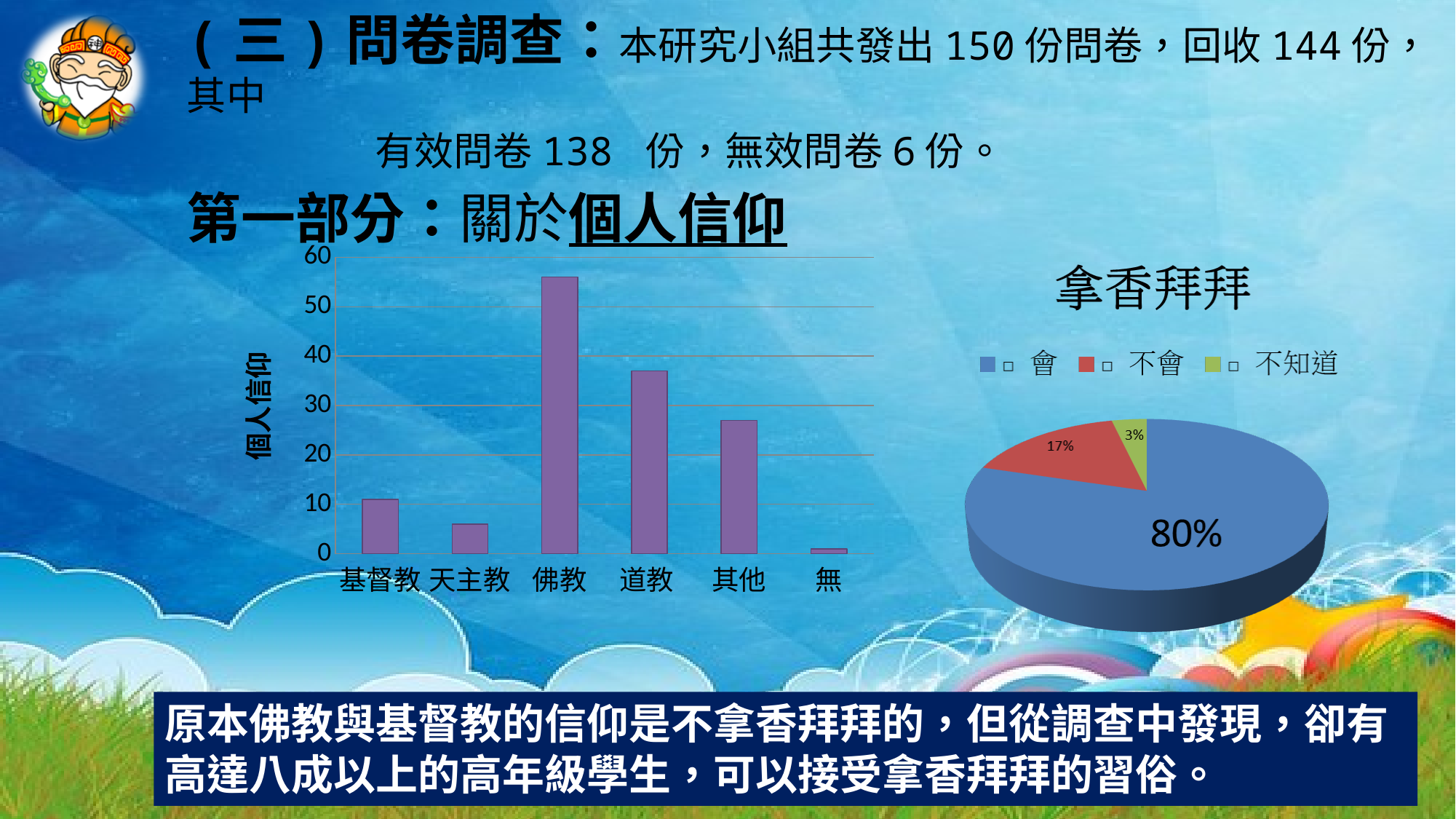
How many entries does the legend of the pie chart 拿香拜拜 list? 3 In the left bar chart (個人信仰), which category has the highest bar? 佛教 How many categories are shown on the x axis of the left bar chart (個人信仰)? 6 What kind of chart is the right chart titled 拿香拜拜? pie chart In the left bar chart (個人信仰), is the value for 天主教 greater or less than 10? less In the left bar chart (個人信仰), which is larger, the value for 道教 or the value for 其他? 道教 What kind of chart is the left chart with the y-axis labelled 個人信仰? bar chart In the pie chart 拿香拜拜, what share does 會 have? 80% In the pie chart 拿香拜拜, what is the difference in percentage points between 會 and 不會? 63 In the pie chart 拿香拜拜, what is the value for 不知道? 3% In the left bar chart (個人信仰), is the value for 佛教 greater or less than 50? greater In the left bar chart (個人信仰), which category has the lowest bar? 無